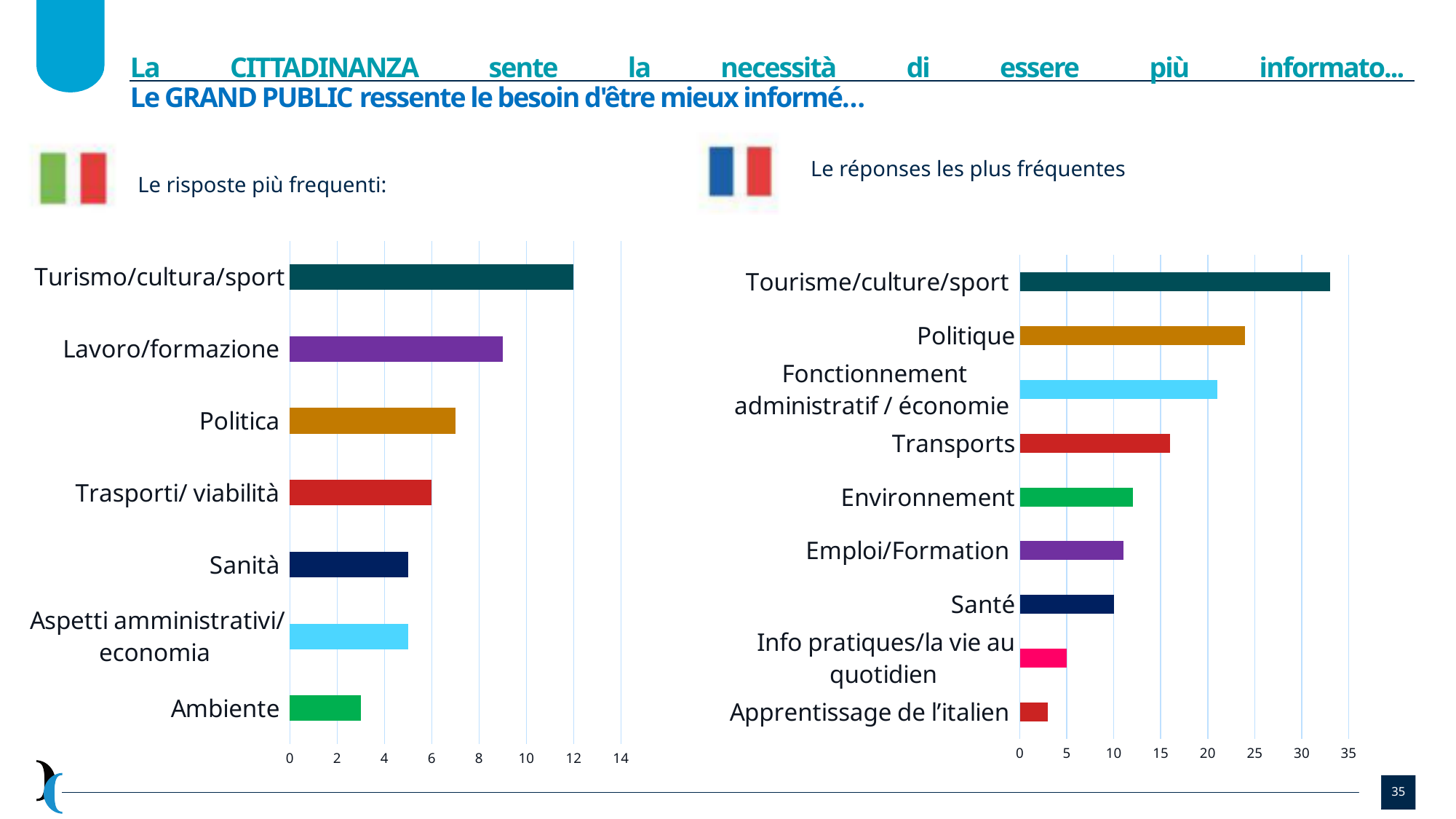
What type of chart is the right chart (Le réponses les plus fréquentes)? Bar chart On the left chart (Le risposte più frequenti), what is the value for Turismo/cultura/sport? 12 On the left chart (Le risposte più frequenti), is the value for Lavoro/formazione greater or less than 8? greater On the right chart (Le réponses les plus fréquentes), how many categories are shown? 9 On the right chart (Le réponses les plus fréquentes), which category has the lowest value? Apprentissage de l'italien On the left chart (Le risposte più frequenti), which category has the highest value? Turismo/cultura/sport On the left chart (Le risposte più frequenti), what is the value for Trasporti/ viabilità? 6 On the right chart (Le réponses les plus fréquentes), is the value for Tourisme/culture/sport greater or less than 30? greater On the left chart (Le risposte più frequenti), which category has the lowest value? Ambiente On the right chart (Le réponses les plus fréquentes), which category has the highest value? Tourisme/culture/sport On the right chart (Le réponses les plus fréquentes), which is larger, Politique or Transports? Politique On the left chart (Le risposte più frequenti), how many categories are shown? 7